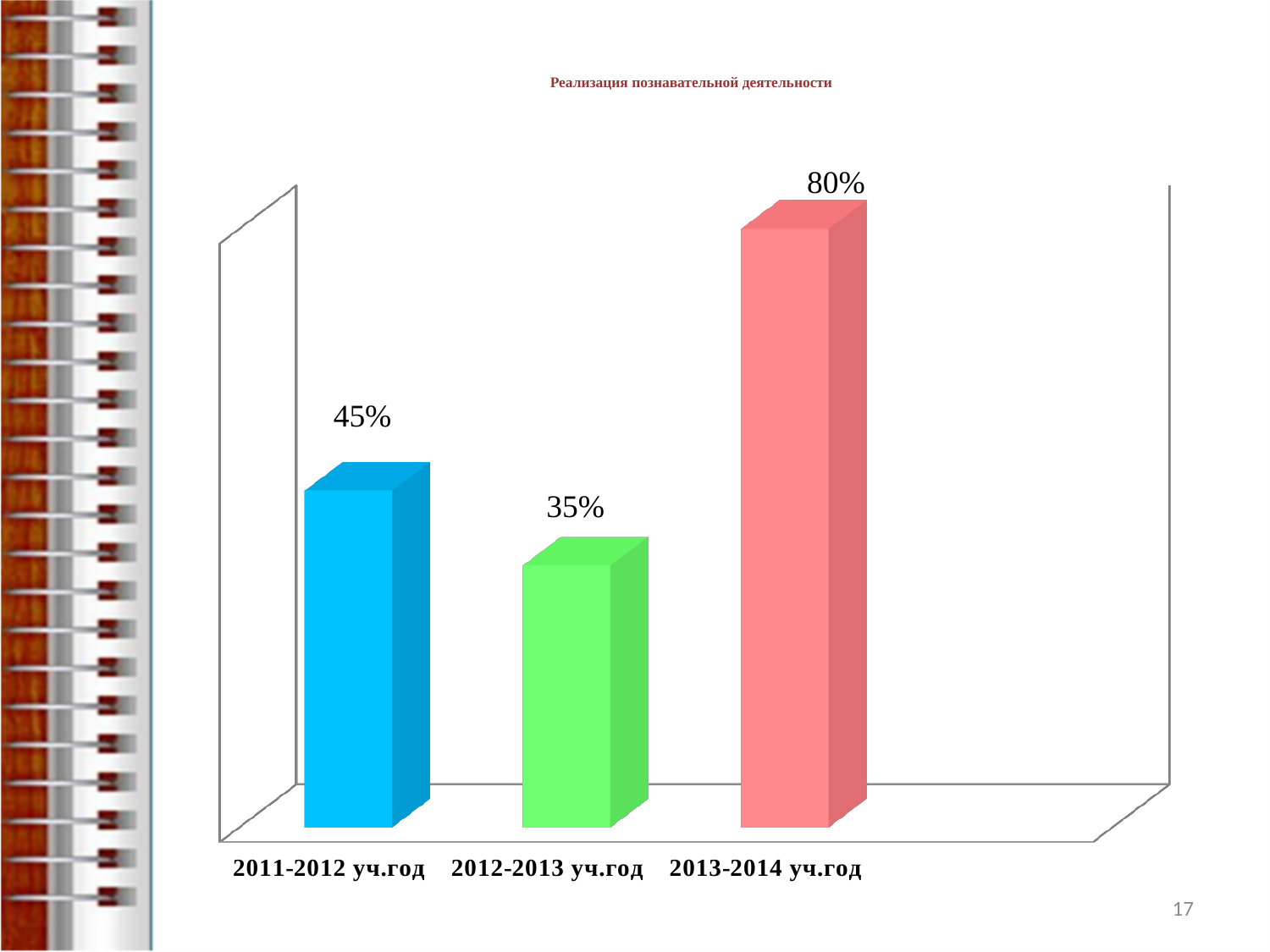
What kind of chart is shown on the slide? bar chart What colour is the bar for 2013-2014 уч.год? pink What is the title of the chart? Реализация познавательной деятельности How many categories are shown on the chart? 3 Which is larger, the value for 2011-2012 уч.год or 2012-2013 уч.год? 2011-2012 уч.год What is the value for 2011-2012 уч.год? 45% What is the value for 2012-2013 уч.год? 35% Which academic year has the lowest value? 2012-2013 уч.год What is the difference between the values for 2013-2014 уч.год and 2011-2012 уч.год? 35% What is the value for 2013-2014 уч.год? 80% Which academic year has the highest value? 2013-2014 уч.год What is the difference between the values for 2011-2012 уч.год and 2012-2013 уч.год? 10%